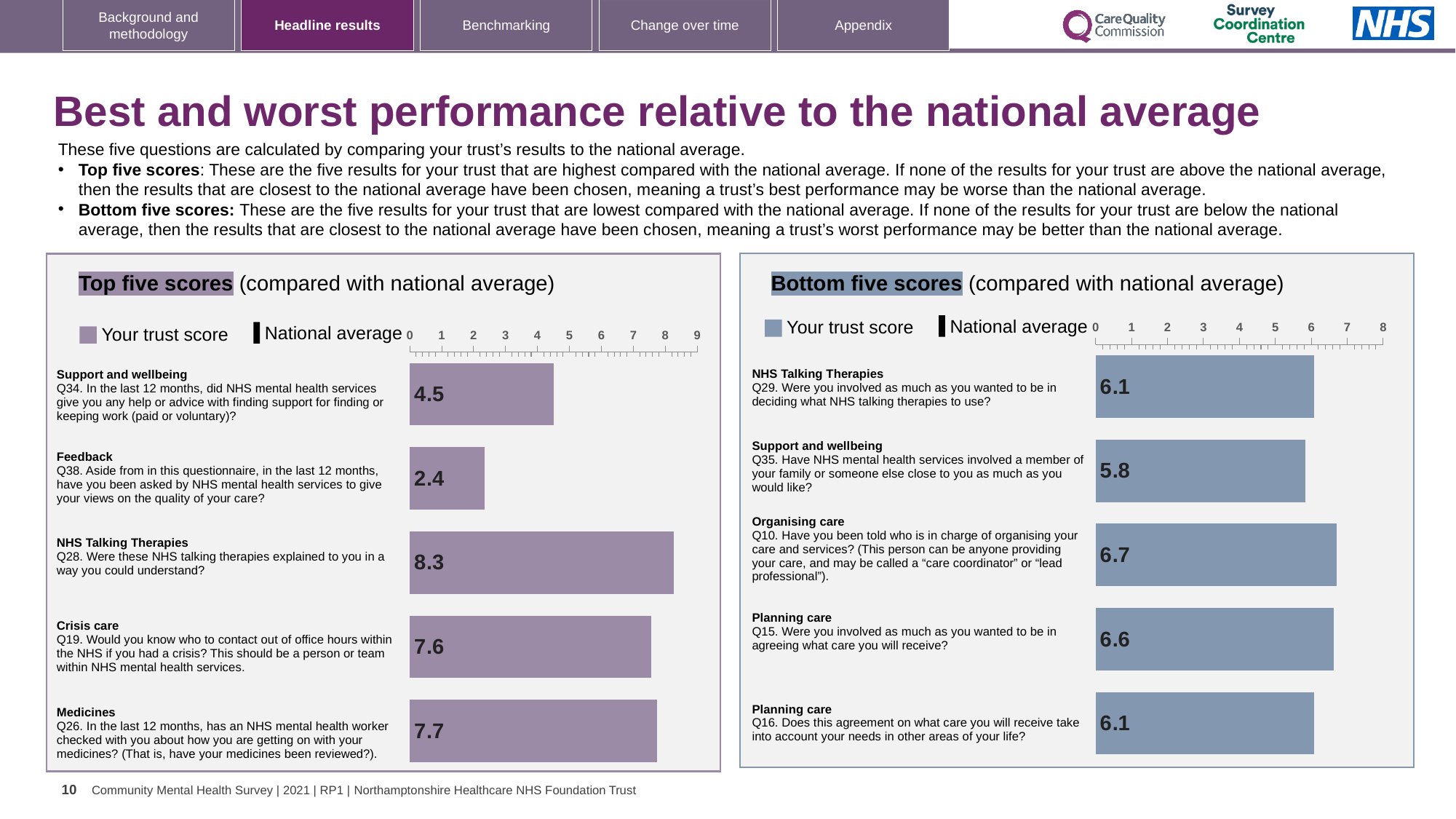
In the Top five scores chart, what is the difference between the trust scores for Q28 and Q38? 5.9 In the Top five scores chart, what is the trust score for Q28 (NHS Talking Therapies)? 8.3 In the Bottom five scores chart, which has the larger trust score, Q29 or Q35? Q29 In the Top five scores chart, which question has the lowest trust score? Q38 (Feedback) In the Bottom five scores chart, what is the trust score for Q35 (Support and wellbeing)? 5.8 In the Top five scores chart, is the trust score for Q19 (Crisis care) greater or less than 7? greater What kind of chart is the Top five scores chart? Bar chart How many questions are shown in the Bottom five scores chart? 5 In the Top five scores chart, which question has the highest trust score? Q28 (NHS Talking Therapies) In the Bottom five scores chart, which question has the lowest trust score? Q35 (Support and wellbeing) What is the highest value shown on the axis of the Bottom five scores chart? 8 In the Bottom five scores chart, which question has the highest trust score? Q10 (Organising care)